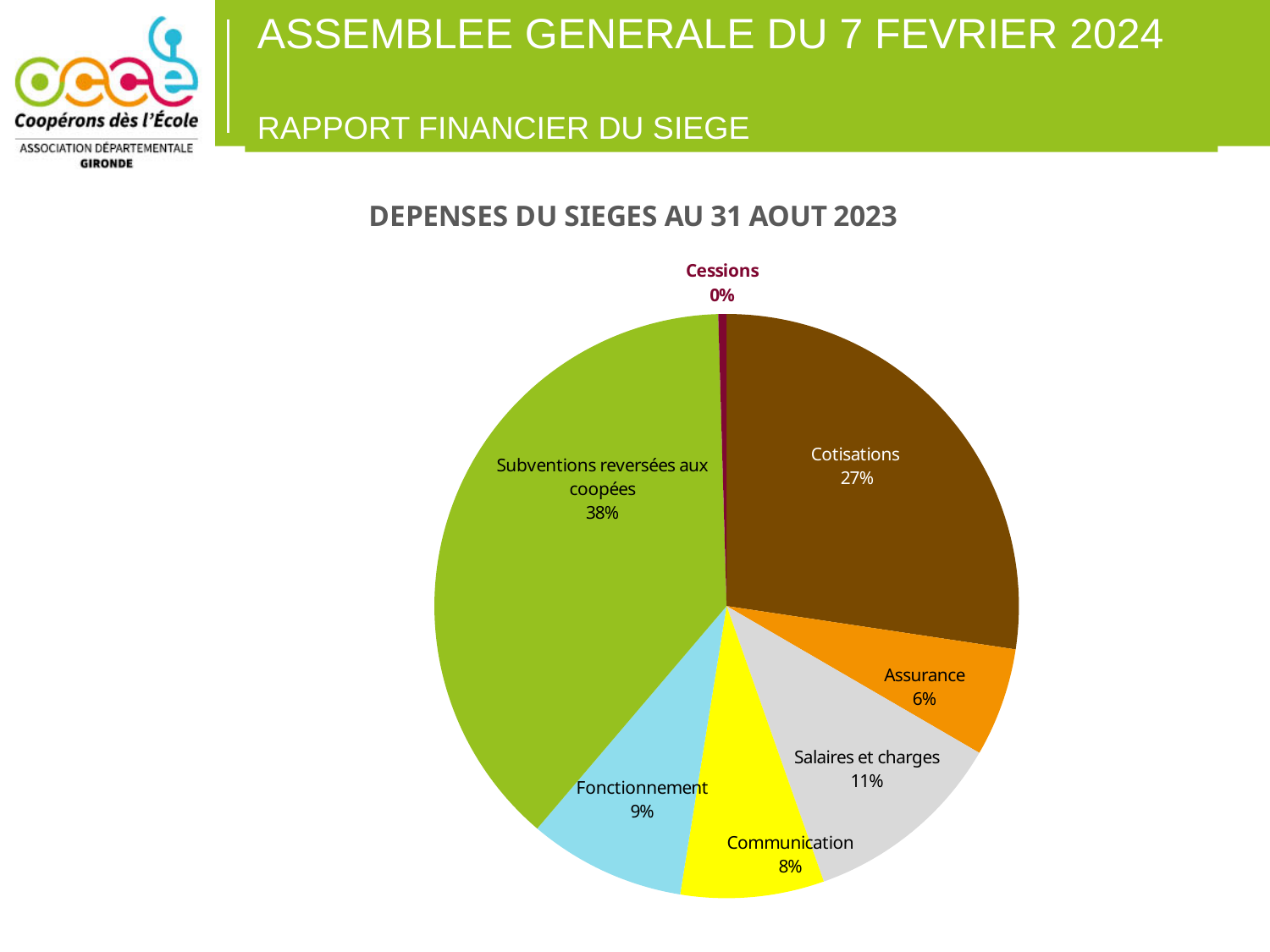
Which is larger, Fonctionnement or Communication? Fonctionnement How many categories are shown in the pie chart? 7 What is the title of the chart? DEPENSES DU SIEGES AU 31 AOUT 2023 What type of chart is shown on the slide? pie chart What share of the pie is Cotisations? 27% What share of the pie is Assurance? 6% What is the difference in percentage points between Subventions reversées aux coopées and Cotisations? 11 What share of the pie is Subventions reversées aux coopées? 38% Which category has the largest share of the pie? Subventions reversées aux coopées Which category has the smallest share of the pie? Cessions What share of the pie is Cessions? 0% What share of the pie is Salaires et charges? 11%